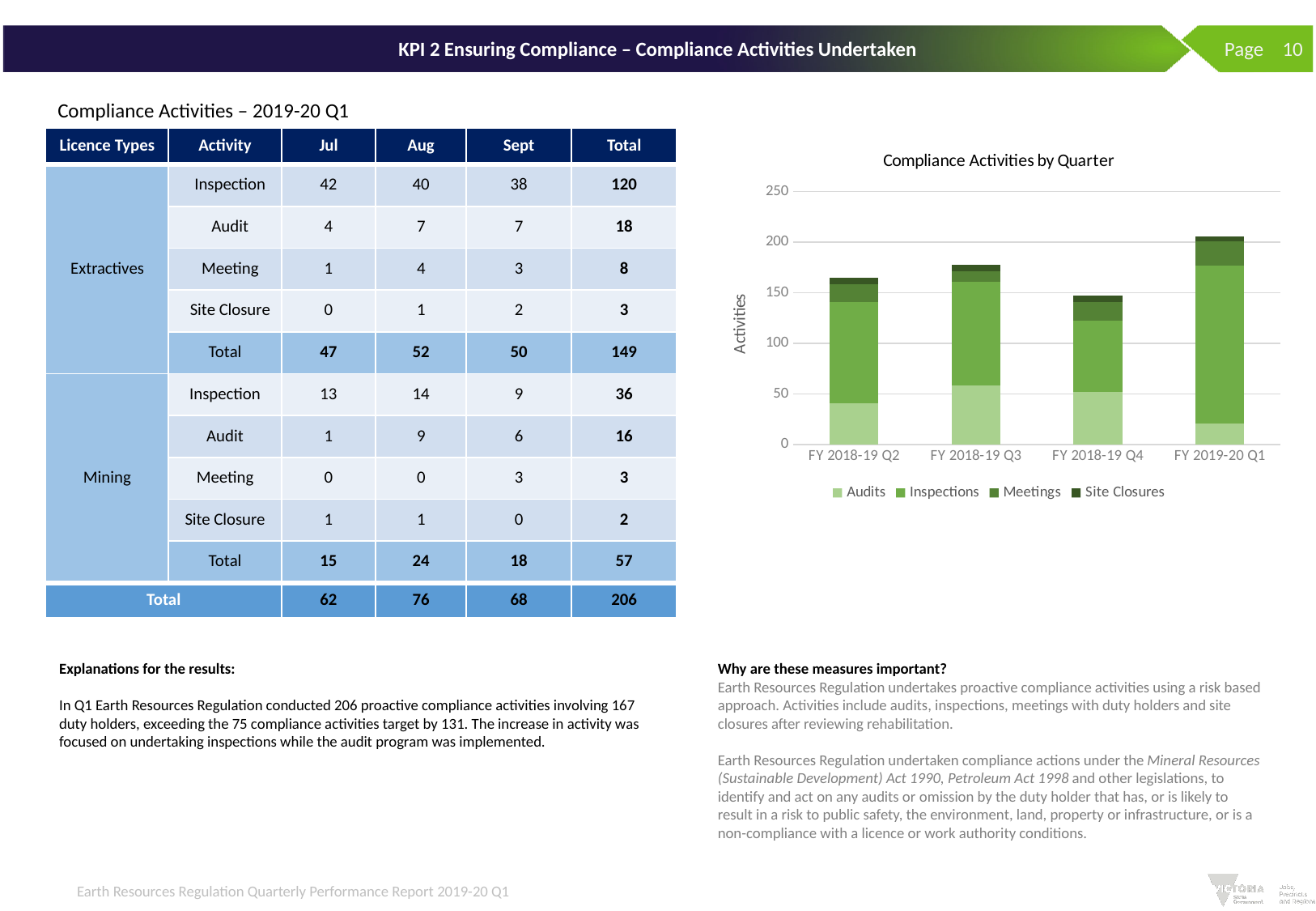
In the 'Compliance Activities by Quarter' chart, which quarter has the tallest stacked bar? FY 2019-20 Q1 What is the title of the chart on the slide? Compliance Activities by Quarter What kind of chart is 'Compliance Activities by Quarter'? Stacked bar chart In the 'Compliance Activities by Quarter' chart, is the total bar height for FY 2018-19 Q3 greater or less than 200? less In the 'Compliance Activities by Quarter' chart, is the total bar height for FY 2019-20 Q1 greater or less than 200? greater How many quarters are shown on the x axis of the 'Compliance Activities by Quarter' chart? 4 What is the label on the vertical axis of the 'Compliance Activities by Quarter' chart? Activities In the 'Compliance Activities by Quarter' chart, which quarter has the shortest stacked bar? FY 2018-19 Q4 In the 'Compliance Activities by Quarter' chart, is the Audits segment for FY 2019-20 Q1 greater or less than 50? less How many series does the legend of the 'Compliance Activities by Quarter' chart list? 4 In the 'Compliance Activities by Quarter' chart, which stacked bar is taller: FY 2018-19 Q2 or FY 2019-20 Q1? FY 2019-20 Q1 In the 'Compliance Activities by Quarter' chart, does the total bar height rise or fall from FY 2018-19 Q4 to FY 2019-20 Q1? rise